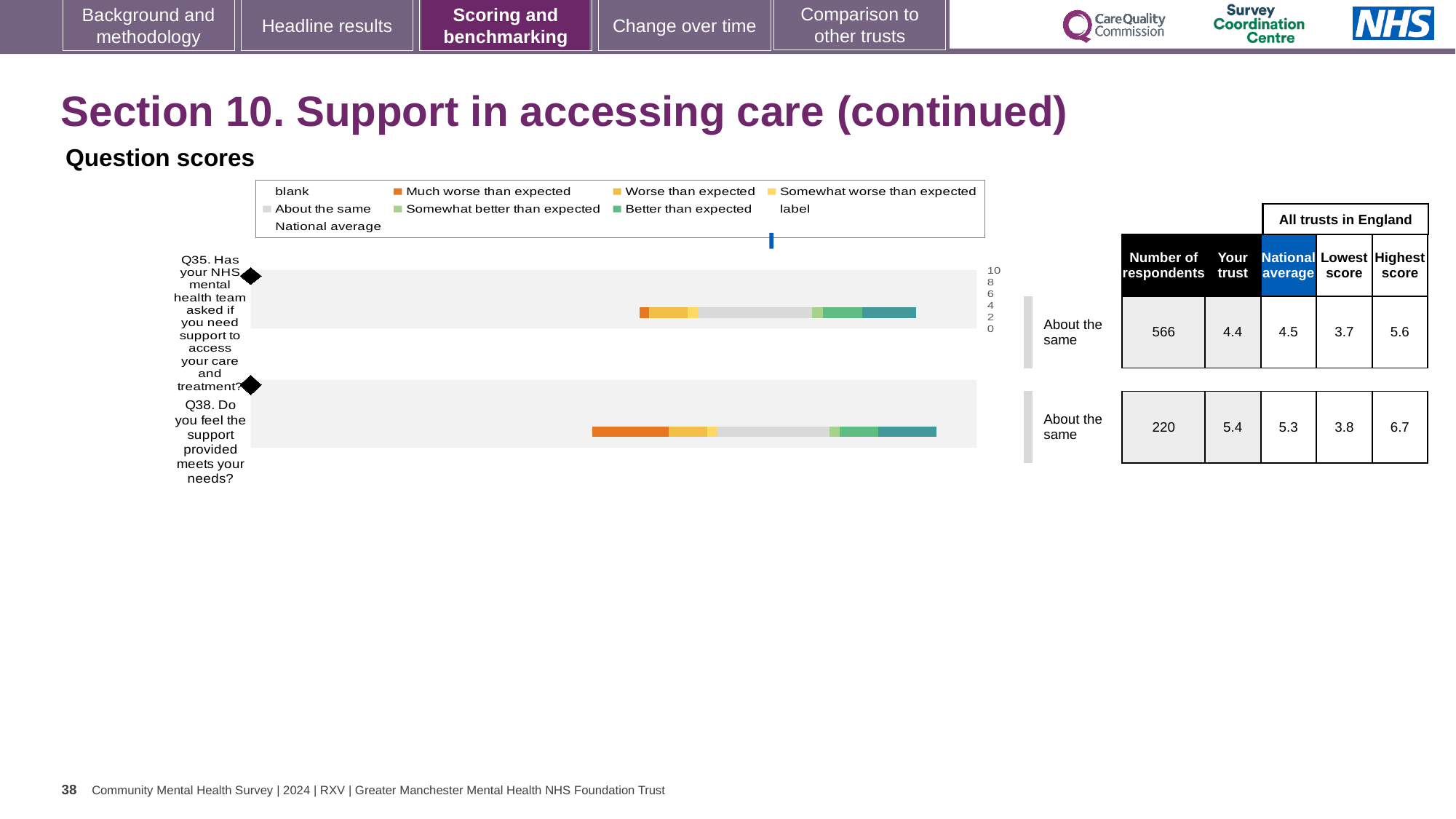
How many questions are plotted in the question scores chart? 2 What is the 'Your trust' score for Q35 (Has your NHS mental health team asked if you need support to access your care and treatment?)? 4.4 How many respondents answered Q35? 566 What is the difference between the highest score and the lowest score across all trusts in England for Q38? 2.9 What benchmarking category is shown next to the bar for Q35? About the same What is the national average score for Q35? 4.5 What is the 'Your trust' score for Q38 (Do you feel the support provided meets your needs?)? 5.4 What kind of chart is used to show the question scores on this slide? bar chart What is the national average score for Q38? 5.3 Which question has the higher 'Your trust' score, Q35 or Q38? Q38 How many respondents answered Q38? 220 What is the difference between the highest score and the lowest score across all trusts in England for Q35? 1.9